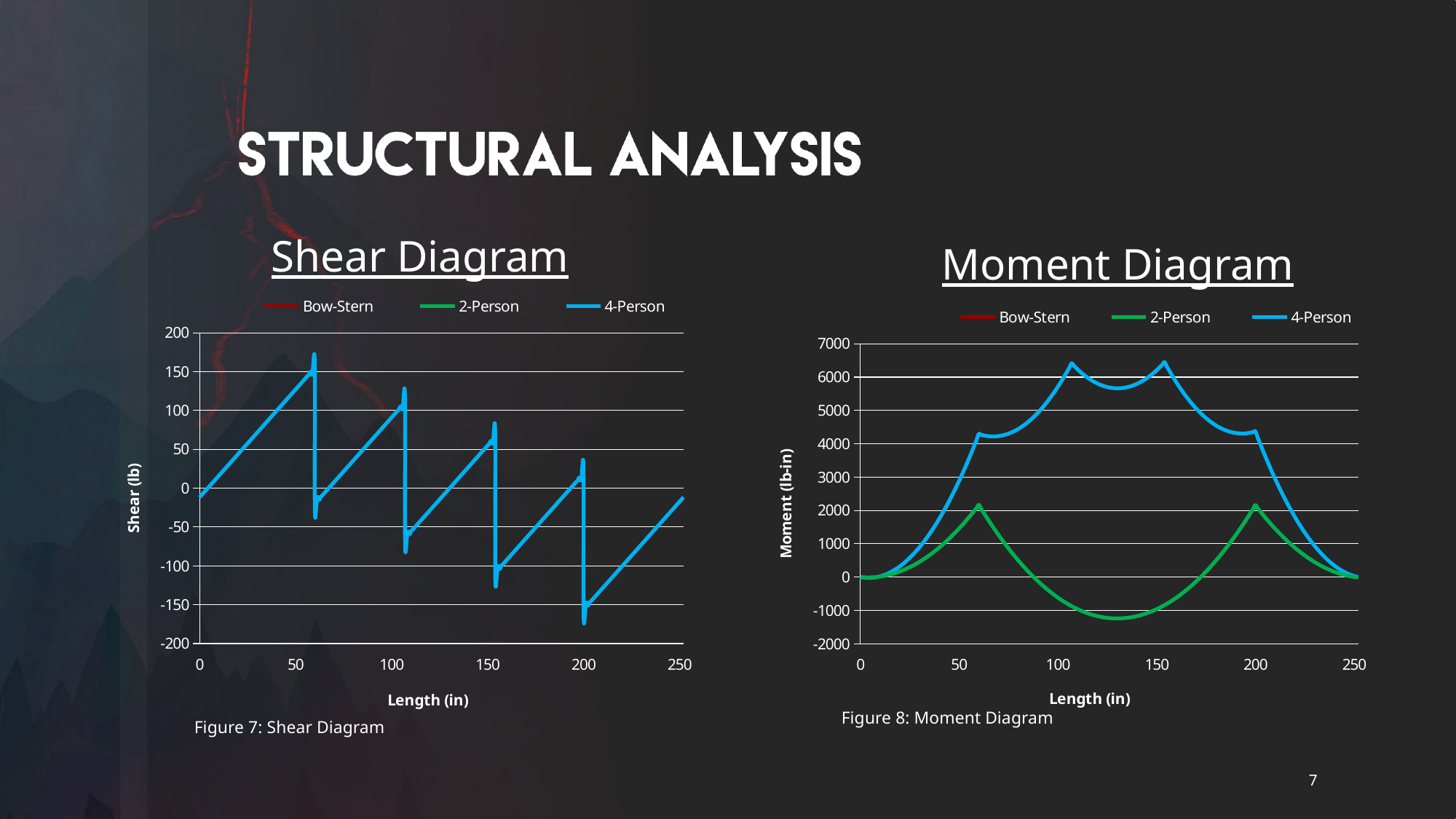
What kind of chart is the Shear Diagram? line chart What kind of chart is the Moment Diagram? line chart In the Moment Diagram, does the 2-Person series rise or fall between lengths of 60 in and 130 in? fall What is the x-axis label of the Shear Diagram? Length (in) What is the y-axis label of the Moment Diagram? Moment (lb-in) How many series does the legend of the Moment Diagram list? 3 In the Shear Diagram, is the highest value of the 4-Person series greater or less than 150? greater In the Shear Diagram, is the lowest value of the 4-Person series greater or less than -150? less In the Moment Diagram, is the lowest value of the 2-Person series greater or less than -1000? less How many series does the legend of the Shear Diagram list? 3